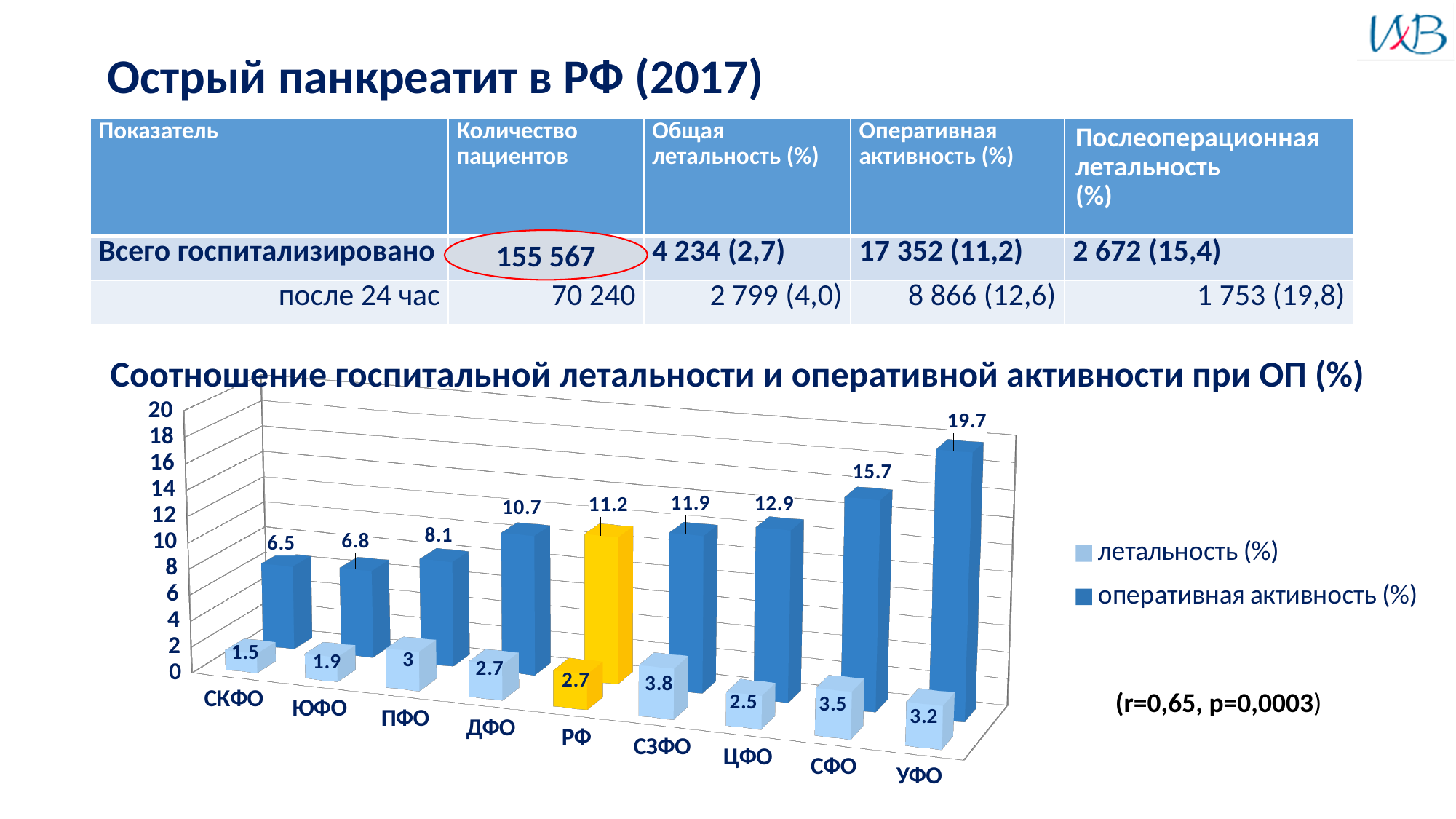
What is the difference between the оперативная активность (%) values for УФО and СКФО? 13.2 How many series does the legend list? 2 What kind of chart is shown on the slide? bar chart Which is larger, the летальность (%) for СФО or for ЦФО? СФО What is the летальность (%) value for СЗФО? 3.8 Do the оперативная активность (%) values rise or fall from СКФО to УФО along the x axis? rise Which category has the lowest летальность (%)? СКФО What is the оперативная активность (%) value for РФ? 11.2 Which category has the highest оперативная активность (%)? УФО How many categories are shown on the x axis? 9 Which category's bars are highlighted in yellow? РФ What is the оперативная активность (%) value for УФО? 19.7